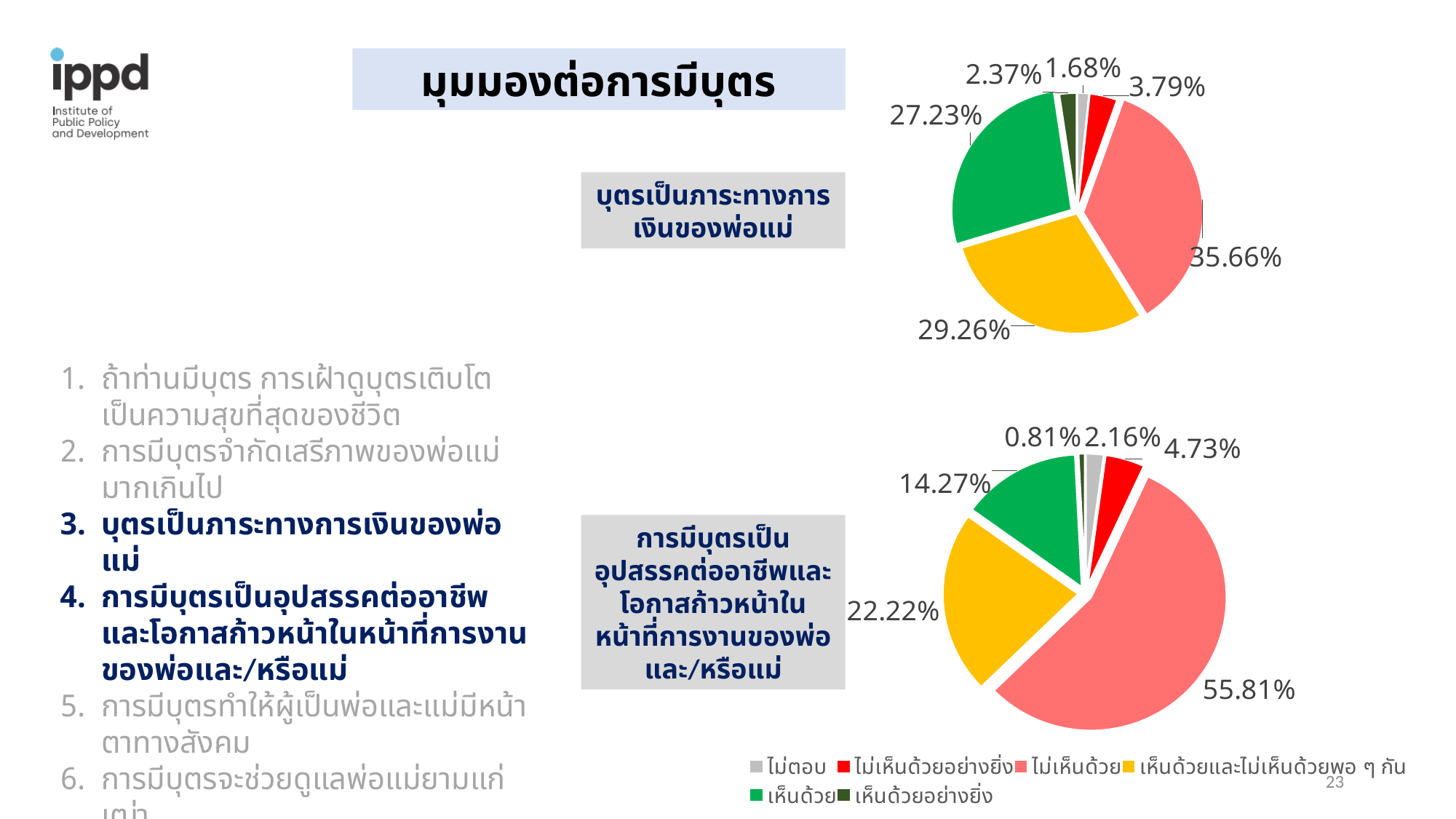
In the bottom pie chart (การมีบุตรเป็นอุปสรรคต่ออาชีพ...), which category has the largest share? ไม่เห็นด้วย (55.81%) In the bottom pie chart (การมีบุตรเป็นอุปสรรคต่ออาชีพ...), which is larger: เห็นด้วย or เห็นด้วยและไม่เห็นด้วยพอ ๆ กัน? เห็นด้วยและไม่เห็นด้วยพอ ๆ กัน In the top pie chart (บุตรเป็นภาระทางการเงินของพ่อแม่), which category has the smallest share? ไม่ตอบ (1.68%) In the top pie chart (บุตรเป็นภาระทางการเงินของพ่อแม่), what share is เห็นด้วยและไม่เห็นด้วยพอ ๆ กัน? 29.26% In the top pie chart (บุตรเป็นภาระทางการเงินของพ่อแม่), what share is เห็นด้วย? 27.23% In the bottom pie chart (การมีบุตรเป็นอุปสรรคต่ออาชีพ...), what share is เห็นด้วยและไม่เห็นด้วยพอ ๆ กัน? 22.22% How many categories does the legend list? 6 In the top pie chart (บุตรเป็นภาระทางการเงินของพ่อแม่), what is the difference between the ไม่เห็นด้วย share and the เห็นด้วย share? 8.43% In the bottom pie chart (การมีบุตรเป็นอุปสรรคต่ออาชีพ...), what share is ไม่เห็นด้วย? 55.81% What kind of chart is used on this slide? Pie chart In the top pie chart (บุตรเป็นภาระทางการเงินของพ่อแม่), what share is ไม่เห็นด้วย? 35.66% Which colour represents ไม่เห็นด้วย in the legend? Pink (light red)